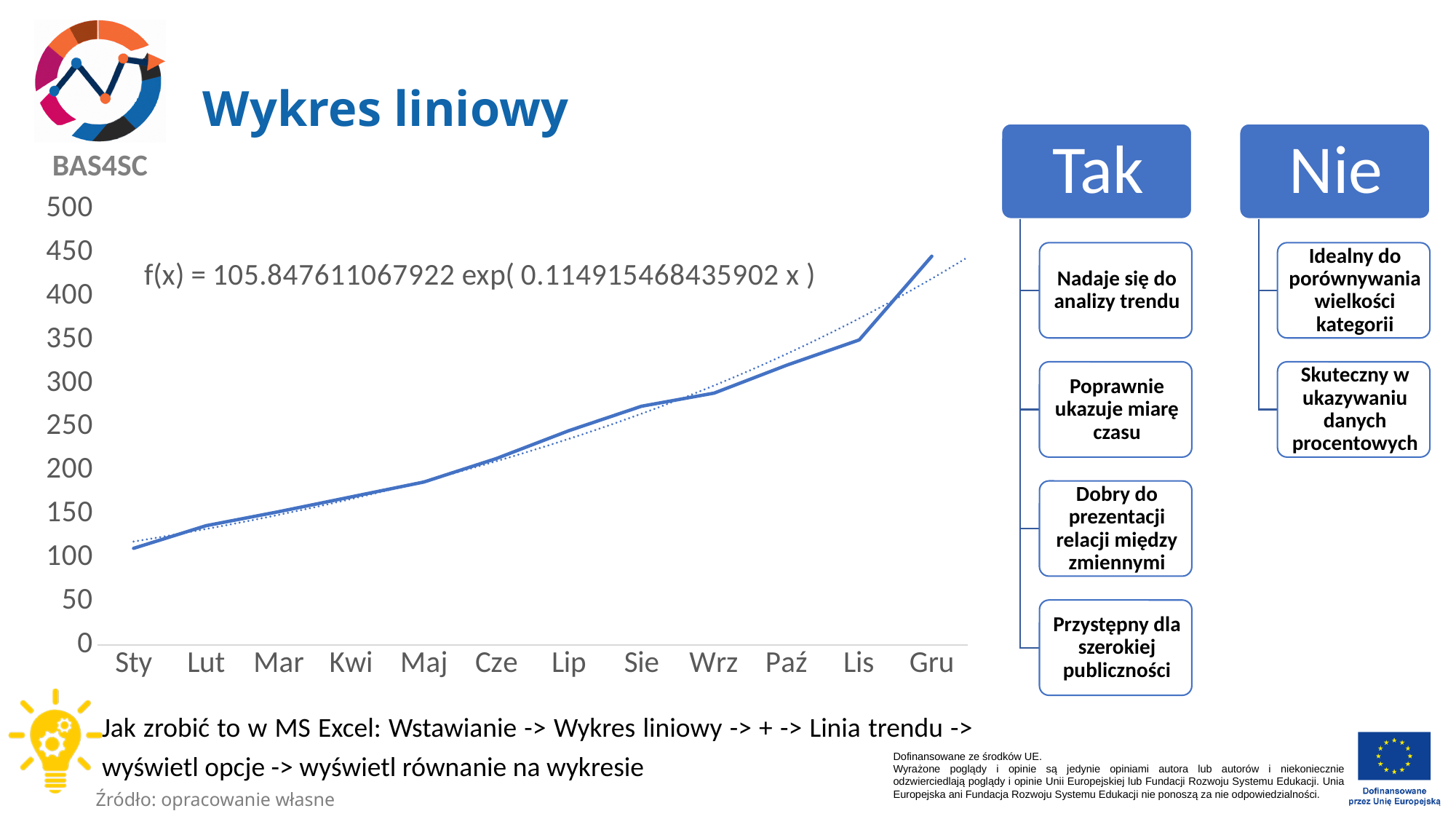
Is the value for Gru greater or less than 400? greater How many categories are shown on the x axis of the chart? 12 Is the value for Sty greater or less than 150? less Do the values in the chart rise or fall from Sty to Gru? rise Which month has the lowest value in the chart? Sty Which month has the highest value in the chart? Gru What kind of chart is shown on the slide? line chart Is the value for Lis greater or less than 300? greater Which is larger, the value for Sie or the value for Kwi? Sie What is the first month label on the x axis of the chart? Sty What is the highest tick value shown on the y axis of the chart? 500